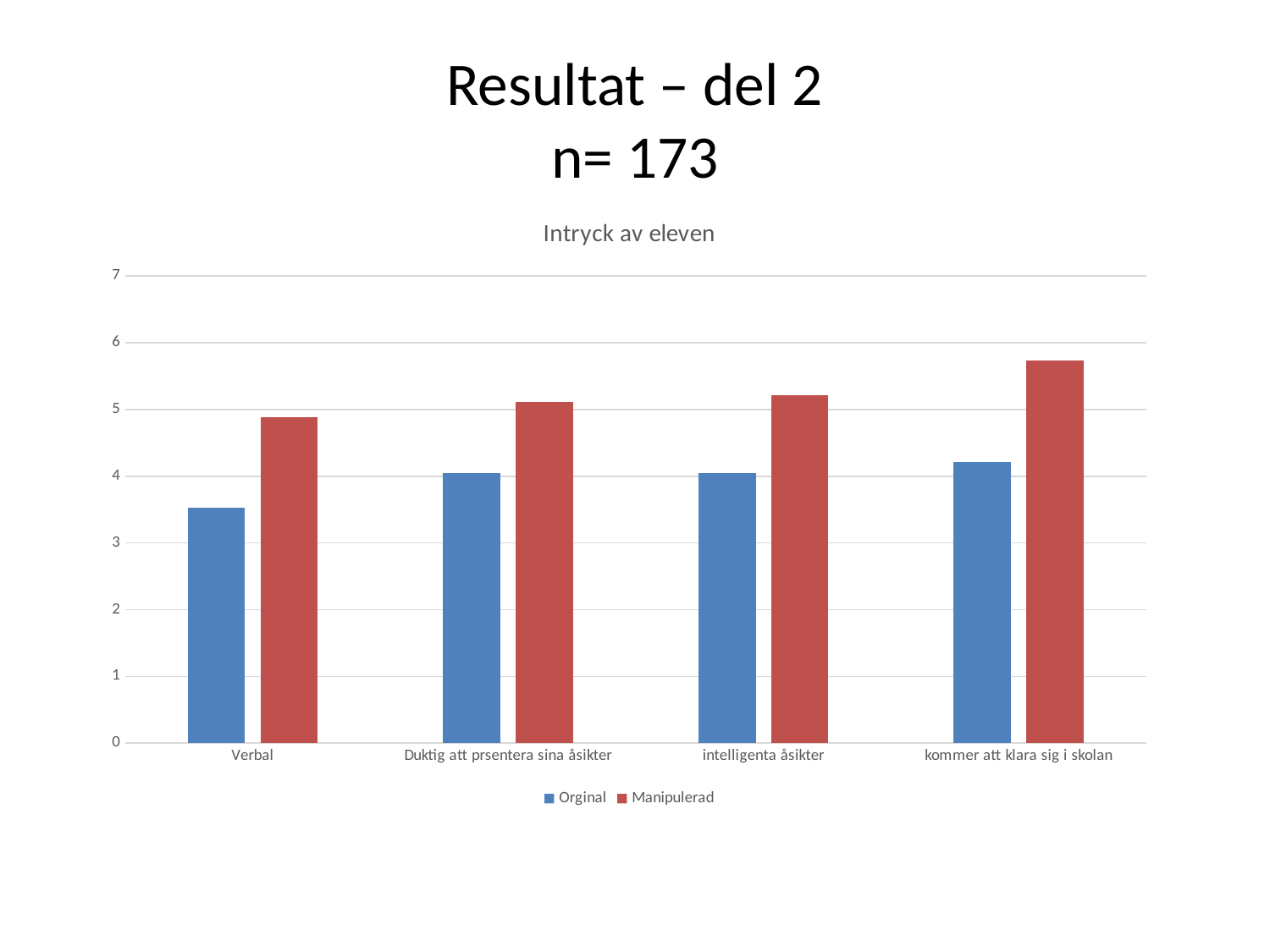
What is the title of the chart? Intryck av eleven How many categories are shown on the x axis? 4 Which category has the lowest value for the Manipulerad series? Verbal Is the Manipulerad value for kommer att klara sig i skolan greater or less than 5? greater Which category has the lowest value for the Orginal series? Verbal What kind of chart is shown on the slide? bar chart Which category has the highest value for the Manipulerad series? kommer att klara sig i skolan For Verbal, which series has the larger value, Orginal or Manipulerad? Manipulerad Do the Manipulerad values rise or fall from Verbal to kommer att klara sig i skolan? rise Is the Orginal value for Verbal greater or less than 4? less Is the Manipulerad value for Verbal greater or less than 5? less How many series does the legend list? 2